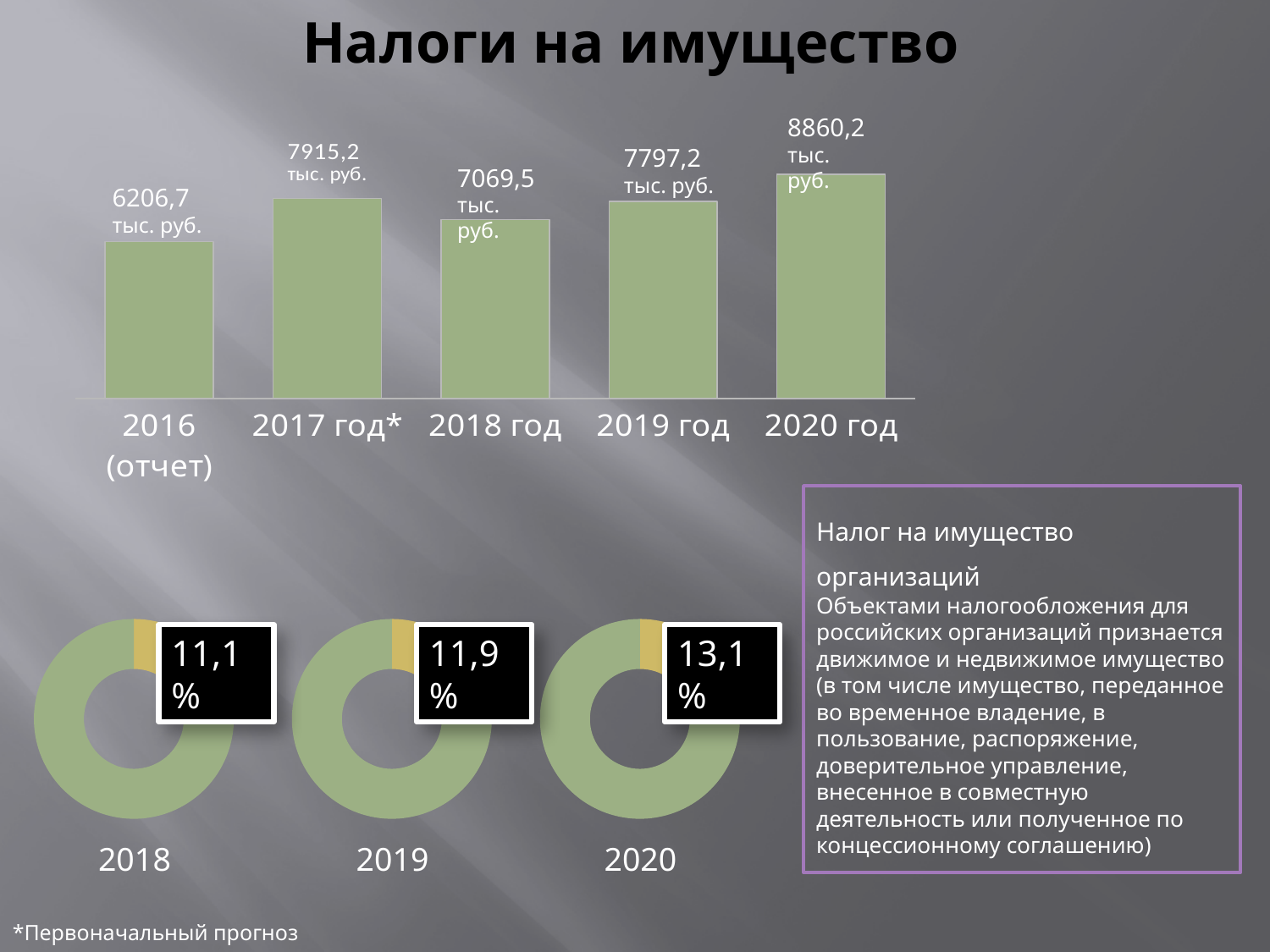
In the bar chart at the top of the slide, which year has the lowest value? 2016 (отчет) In the bar chart at the top of the slide, what is the value for 2016 (отчет)? 6206,7 тыс. руб. What kind of chart is shown at the top of the slide? Bar chart In the donut chart labelled 2019 at the bottom of the slide, what percentage is shown? 11,9% In the bar chart at the top of the slide, what is the value for 2018 год? 7069,5 тыс. руб. In the bar chart at the top of the slide, which year has the highest value? 2020 год What is the title of the slide containing the bar chart? Налоги на имущество In the bar chart at the top of the slide, what is the difference between the values for 2020 год and 2019 год? 1063,0 тыс. руб. In the bar chart at the top of the slide, which is larger: the value for 2017 год* or the value for 2018 год? 2017 год* Among the three donut charts at the bottom of the slide, which year shows the highest percentage? 2020 In the bar chart at the top of the slide, what is the value for 2020 год? 8860,2 тыс. руб. How many bars are in the bar chart at the top of the slide? 5